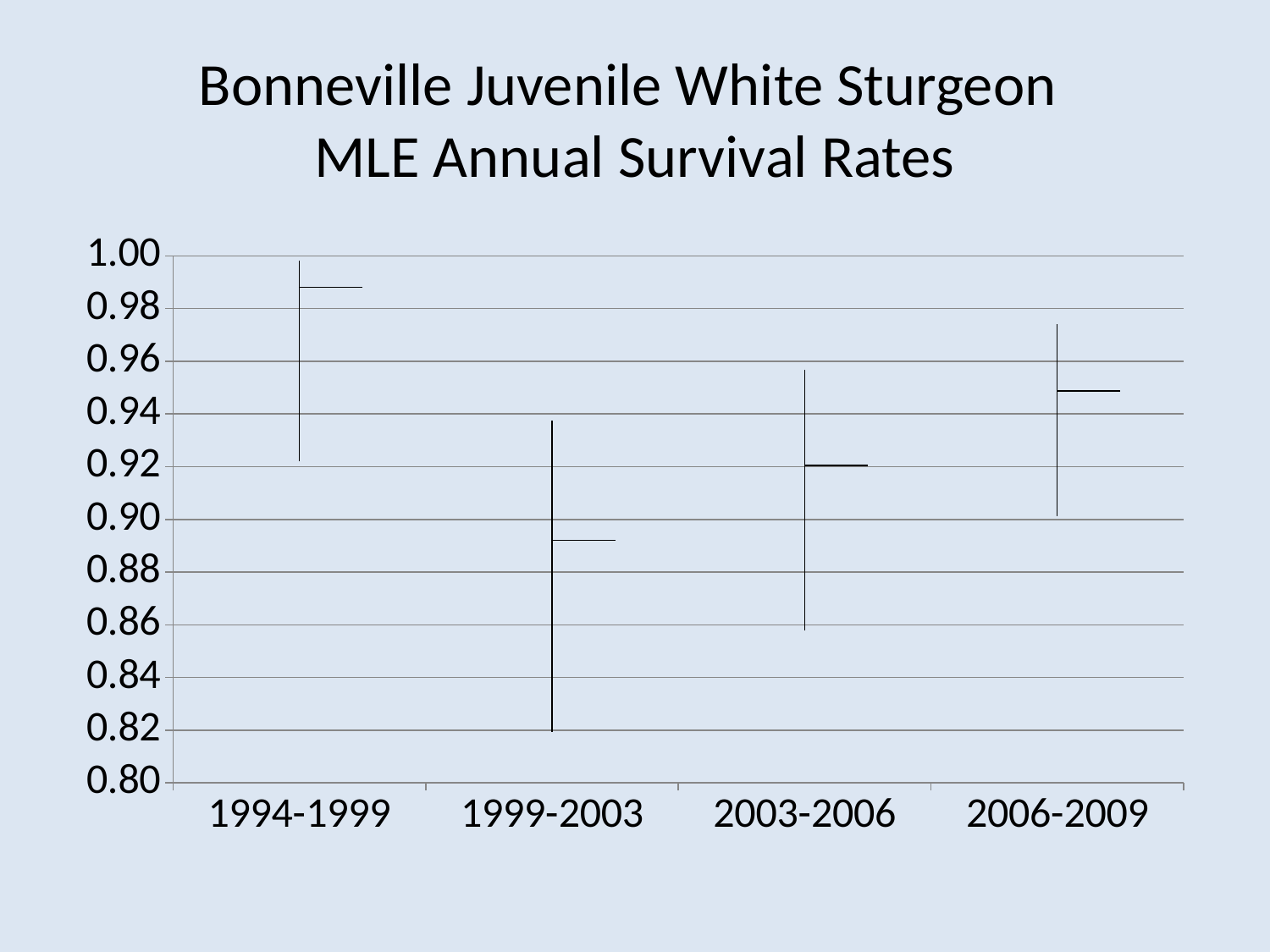
What is the title of the chart? Bonneville Juvenile White Sturgeon MLE Annual Survival Rates Is the upper end of the range shown for 2006-2009 greater or less than 0.98? less Is the survival rate estimate for 2003-2006 greater or less than 0.90? greater Is the survival rate estimate for 1999-2003 greater or less than 0.90? less Which period has the higher survival rate estimate, 1999-2003 or 2003-2006? 2003-2006 What are the minimum and maximum values shown on the y axis? 0.80 and 1.00 Which period has the highest MLE annual survival rate? 1994-1999 Which period has the lowest MLE annual survival rate? 1999-2003 How many time periods are shown on the x axis of the chart? 4 Which period has the higher survival rate estimate, 2003-2006 or 2006-2009? 2006-2009